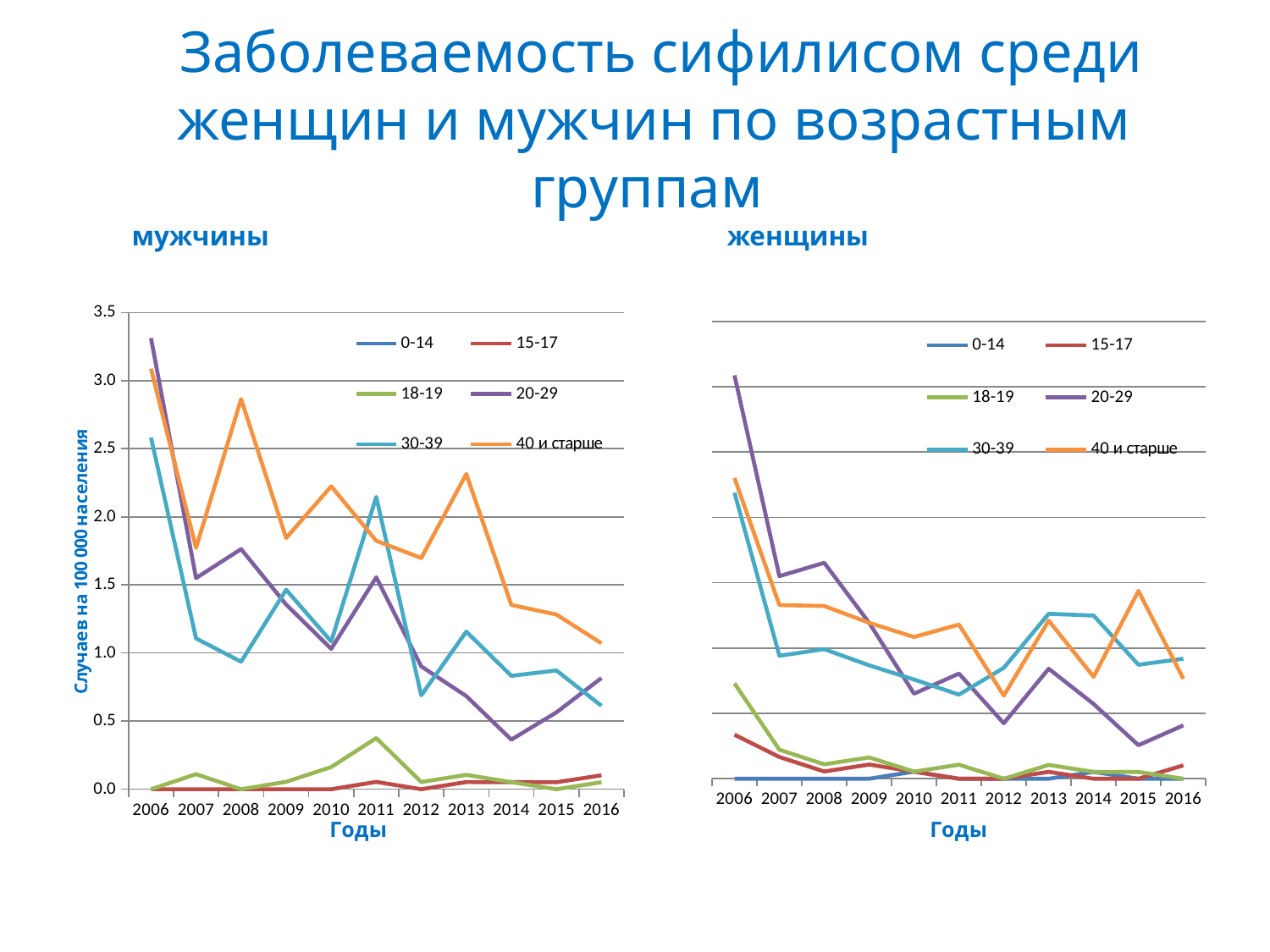
How many years are shown on the x axis of the right chart (женщины)? 11 In the right chart (женщины), which series has the highest value in 2006? 20-29 In the left chart (мужчины), which series has the highest value in 2013? 40 и старше In the right chart (женщины), does the 20-29 series overall rise or fall from 2006 to 2016? fall How many series does the legend of the left chart (мужчины) list? 6 In the left chart (мужчины), is the value for 40 и старше in 2008 greater or less than 2.5? greater What is the y-axis title of the left chart (мужчины)? Случаев на 100 000 населения In the left chart (мужчины), is the value for 20-29 in 2006 greater or less than 3.0? greater In the left chart (мужчины), which is larger in 2011: the value for 30-39 or the value for 20-29? 30-39 In the left chart (мужчины), in which year does the 20-29 series reach its highest value? 2006 In the left chart (мужчины), is the value for 30-39 in 2012 greater or less than 1.0? less What kind of chart is the left chart (мужчины)? line chart